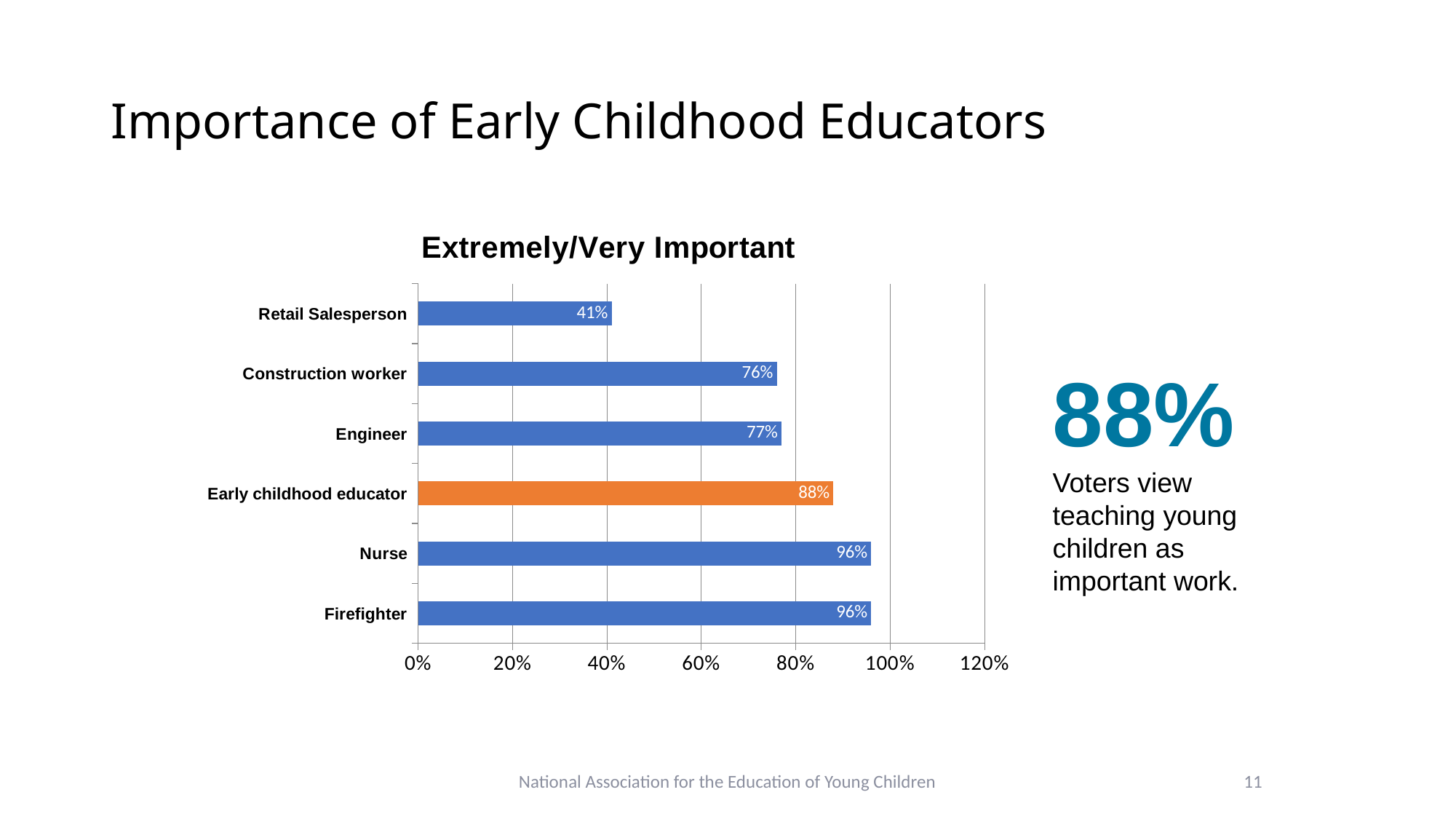
What is the difference between the values for Nurse and Early childhood educator? 8% What kind of chart is shown on the slide? bar chart What is the title of the chart? Extremely/Very Important Which category has the lowest value? Retail Salesperson What is the value for Retail Salesperson? 41% How many categories are shown in the chart? 6 What is the difference between the values for Early childhood educator and Retail Salesperson? 47% Is the value for Construction worker greater or less than 80%? less What is the value for Construction worker? 76% Which is larger, the value for Early childhood educator or the value for Engineer? Early childhood educator What is the value for Engineer? 77% What is the value for Early childhood educator? 88%